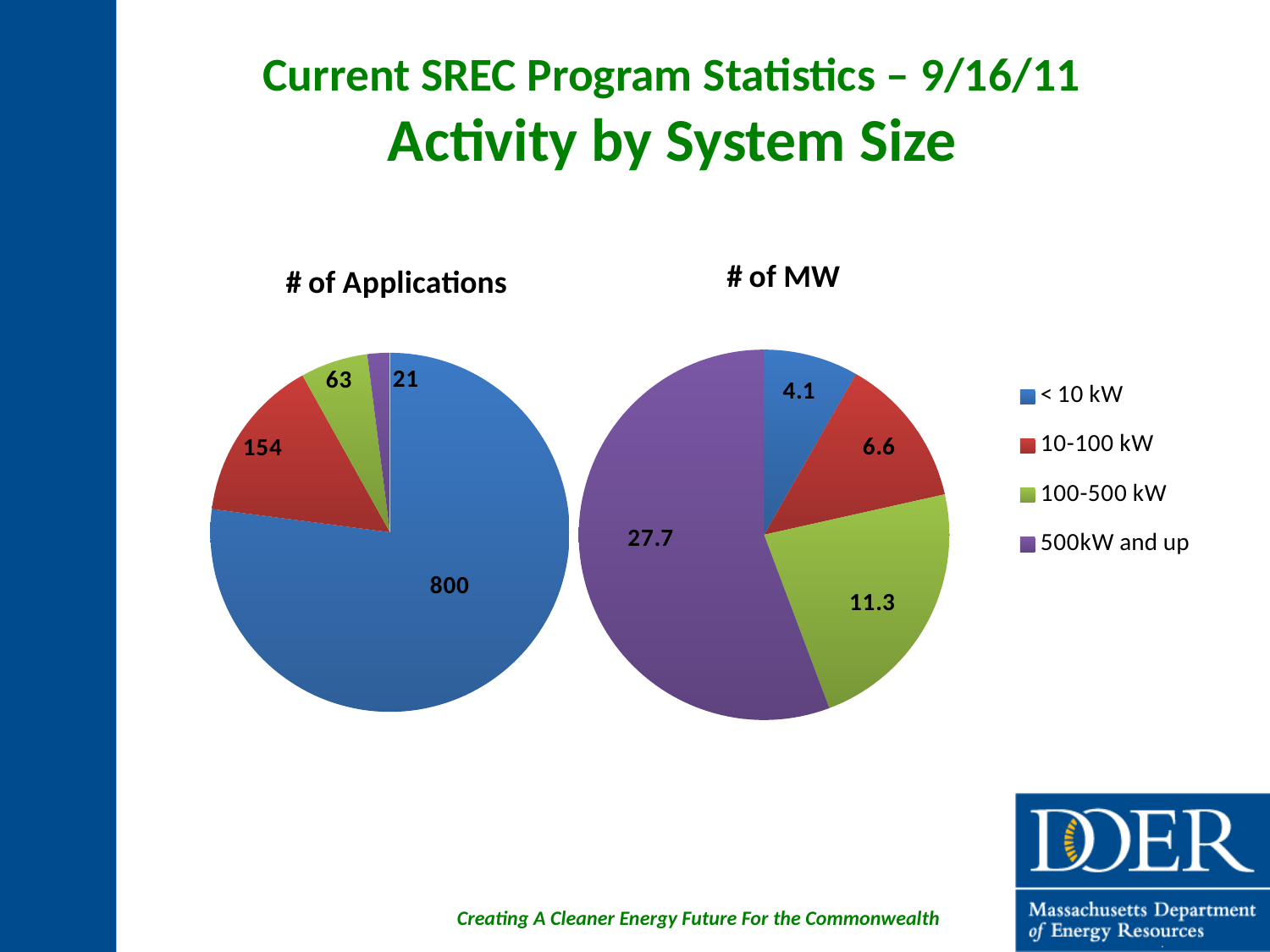
In the '# of MW' chart, which category has the largest slice? 500kW and up In the '# of MW' chart, what is the value for the 500kW and up category? 27.7 How many categories does the legend list for the pie charts? 4 What type of chart is used for '# of Applications' and '# of MW'? Pie chart In the '# of MW' chart, which category has the smallest value? < 10 kW In the '# of Applications' chart, what is the difference between the 10-100 kW and 100-500 kW values? 91 In the '# of Applications' chart, how many applications are in the < 10 kW category? 800 In the '# of MW' chart, which is larger: the value for 10-100 kW or the value for < 10 kW? 10-100 kW In the '# of MW' chart, what is the value for the 100-500 kW category? 11.3 In the '# of MW' chart, what is the difference between the 500kW and up value and the 100-500 kW value? 16.4 In the '# of Applications' chart, what is the value for the 10-100 kW category? 154 In the '# of Applications' chart, which category has the smallest slice? 500kW and up